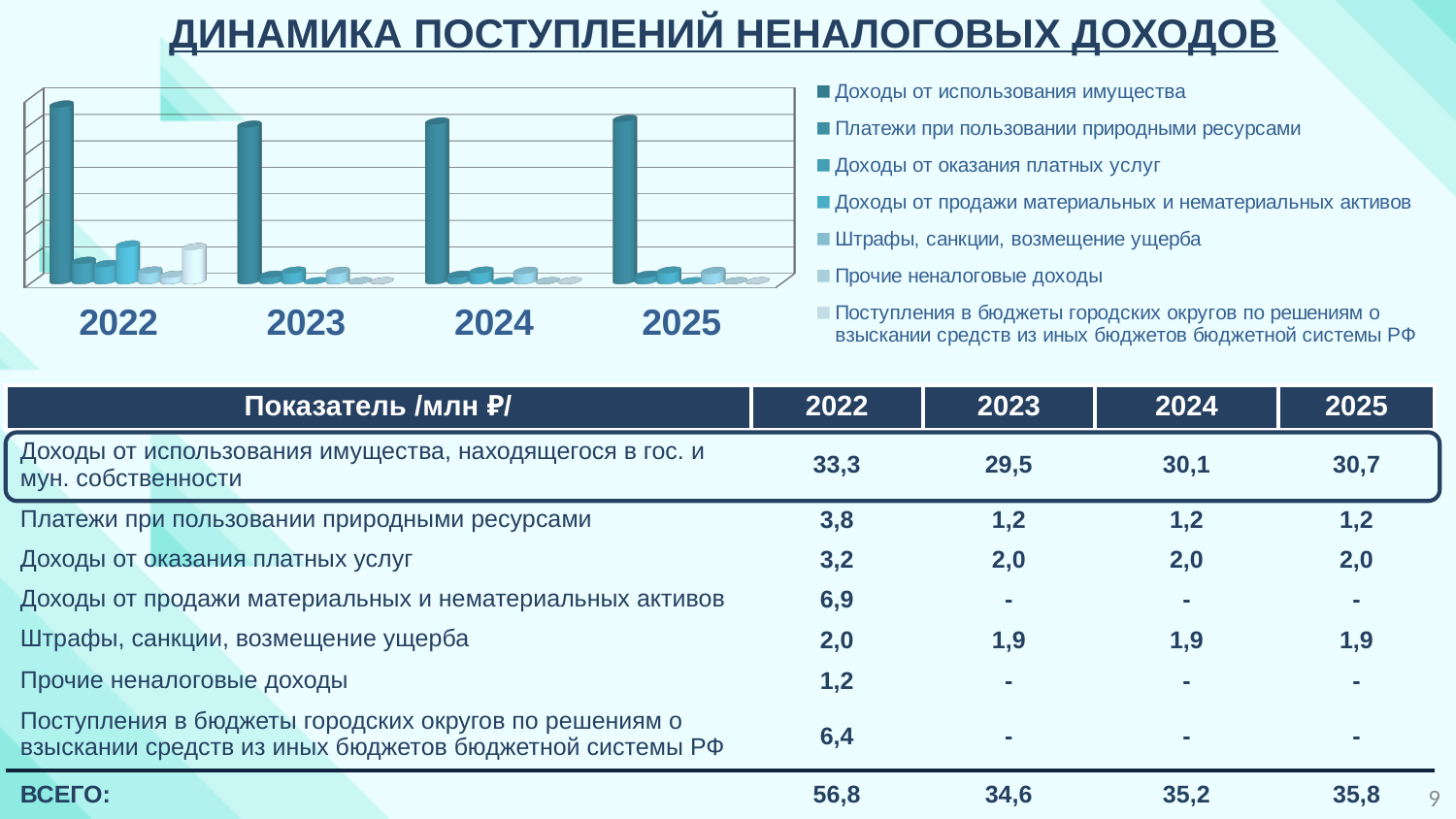
How many years (categories) are shown along the x axis of the chart? 4 What is the value for 'Платежи при пользовании природными ресурсами' in 2022? 3,8 What is the value for 'Доходы от использования имущества' in 2022, in млн ₽? 33,3 Which is larger: the 2022 or the 2025 value for 'Доходы от использования имущества'? 2022 What is the difference between the 2022 and 2023 values for 'Доходы от использования имущества'? 3,8 What kind of chart is shown on the slide? bar chart Which series is the first entry in the chart legend? Доходы от использования имущества Which year has the tallest bar for 'Доходы от использования имущества'? 2022 Does the value for 'Доходы от использования имущества' rise or fall from 2023 to 2025? rise Which year has the lowest value for 'Доходы от использования имущества'? 2023 How many series does the chart legend list? 7 What is the total (ВСЕГО) of non-tax revenues for 2022? 56,8